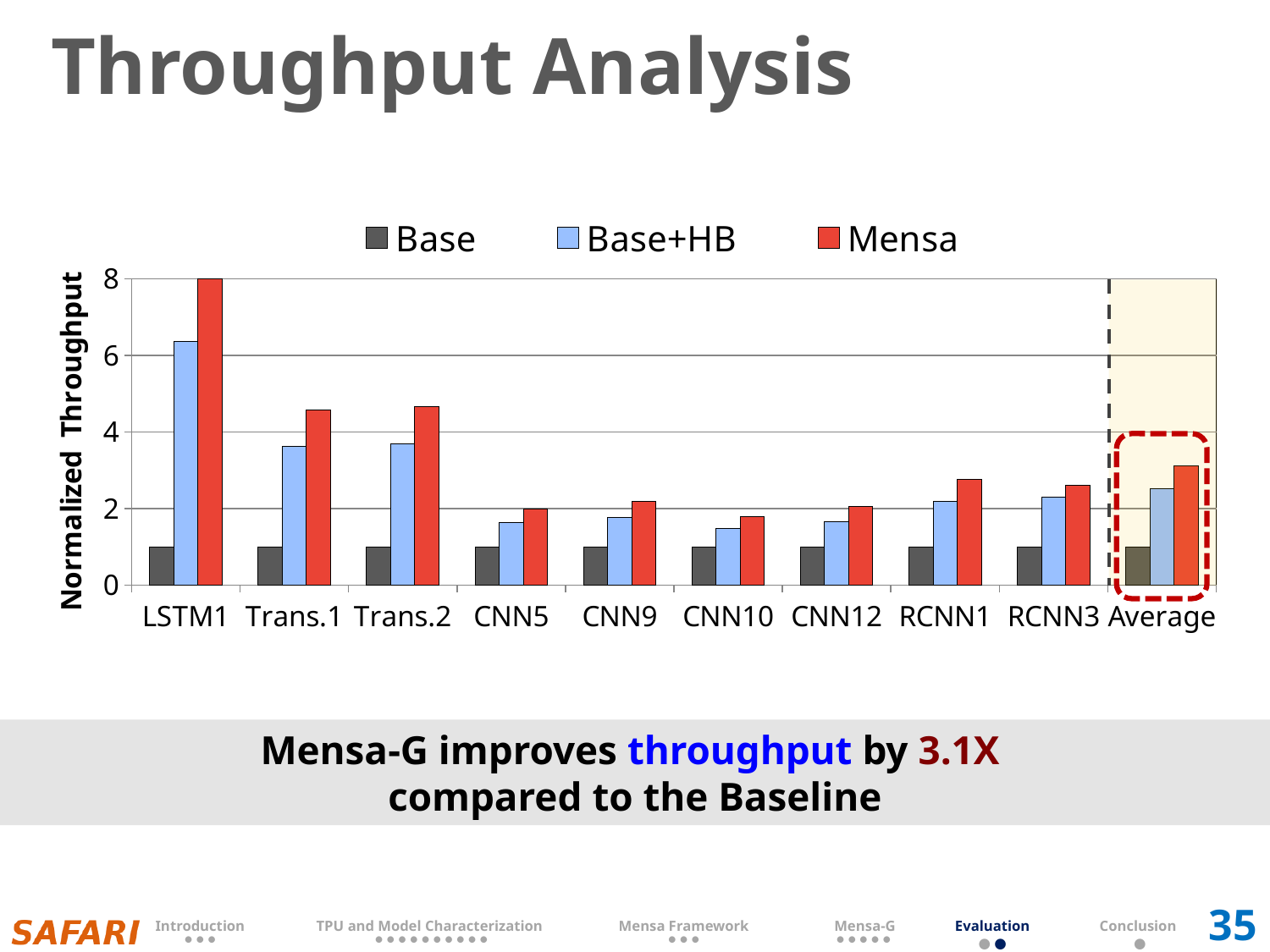
What is the label of the y axis? Normalized Throughput Which has the larger Mensa value, RCNN1 or CNN12? RCNN1 What kind of chart is shown on the slide? bar chart For CNN5, which series has the larger value, Base+HB or Mensa? Mensa Is the Mensa value for Average greater or less than 2? greater Is the Base+HB value for LSTM1 greater or less than 6? greater Is the Mensa value for Trans.1 greater or less than 4? greater Which category has the highest Mensa value? LSTM1 How many categories are shown on the x axis? 10 How many series does the legend list? 3 Which has the larger Mensa value, LSTM1 or Trans.1? LSTM1